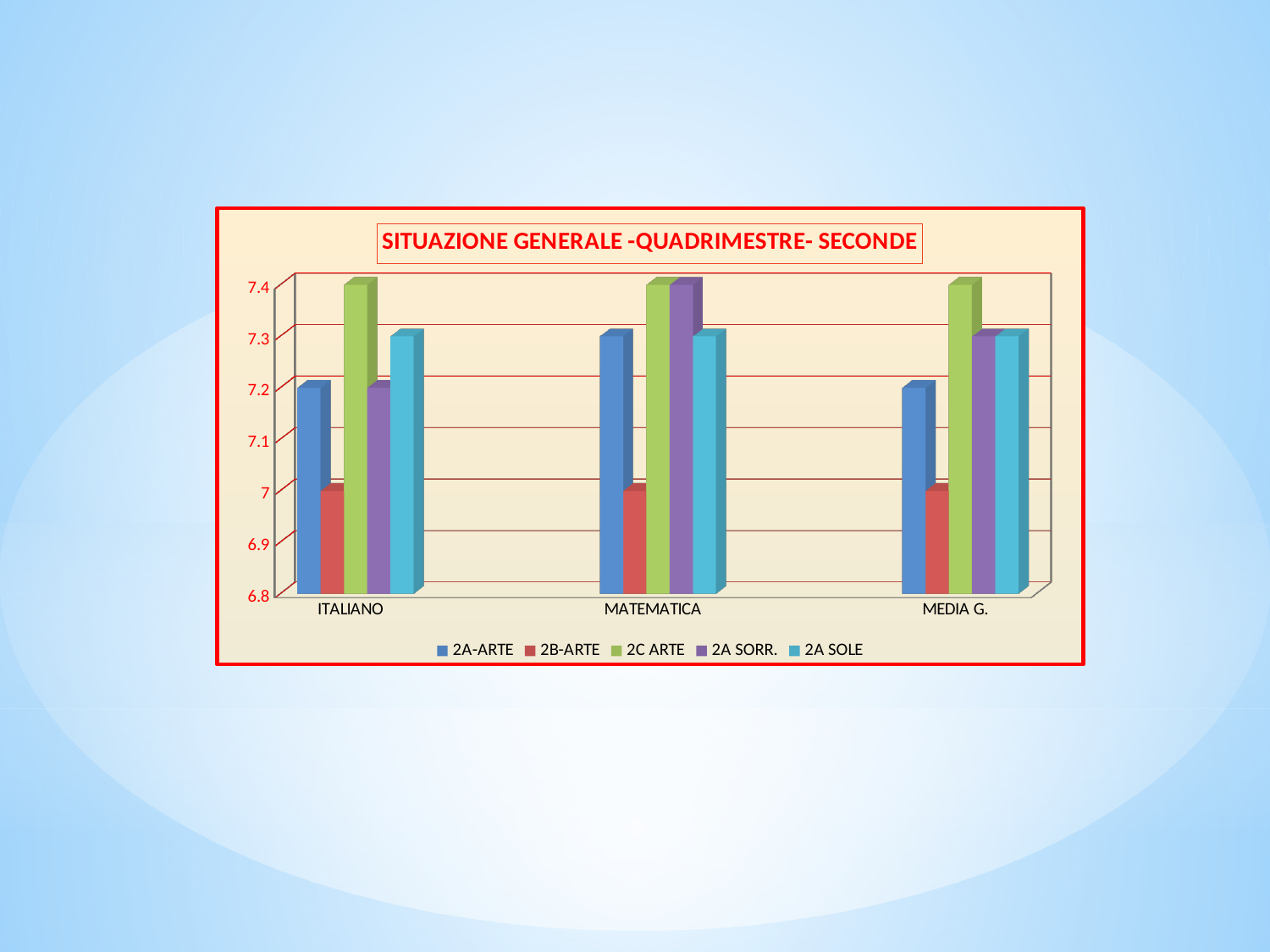
Which is larger for MEDIA G.: 2C ARTE or 2A-ARTE? 2C ARTE How many categories are shown on the x axis? 3 How many series does the legend list? 5 Which series has the lowest value for ITALIANO? 2B-ARTE Which series has the lowest value for MEDIA G.? 2B-ARTE Which series has the highest value for ITALIANO? 2C ARTE Is the value of 2C ARTE for MATEMATICA greater or less than 7.3? greater Which series is shown in red in the legend? 2B-ARTE What is the title of the chart? SITUAZIONE GENERALE -QUADRIMESTRE- SECONDE Which is larger for ITALIANO: 2A SOLE or 2A SORR.? 2A SOLE What kind of chart is shown on the slide? bar chart Is the value of 2B-ARTE for MATEMATICA greater or less than 7.2? less